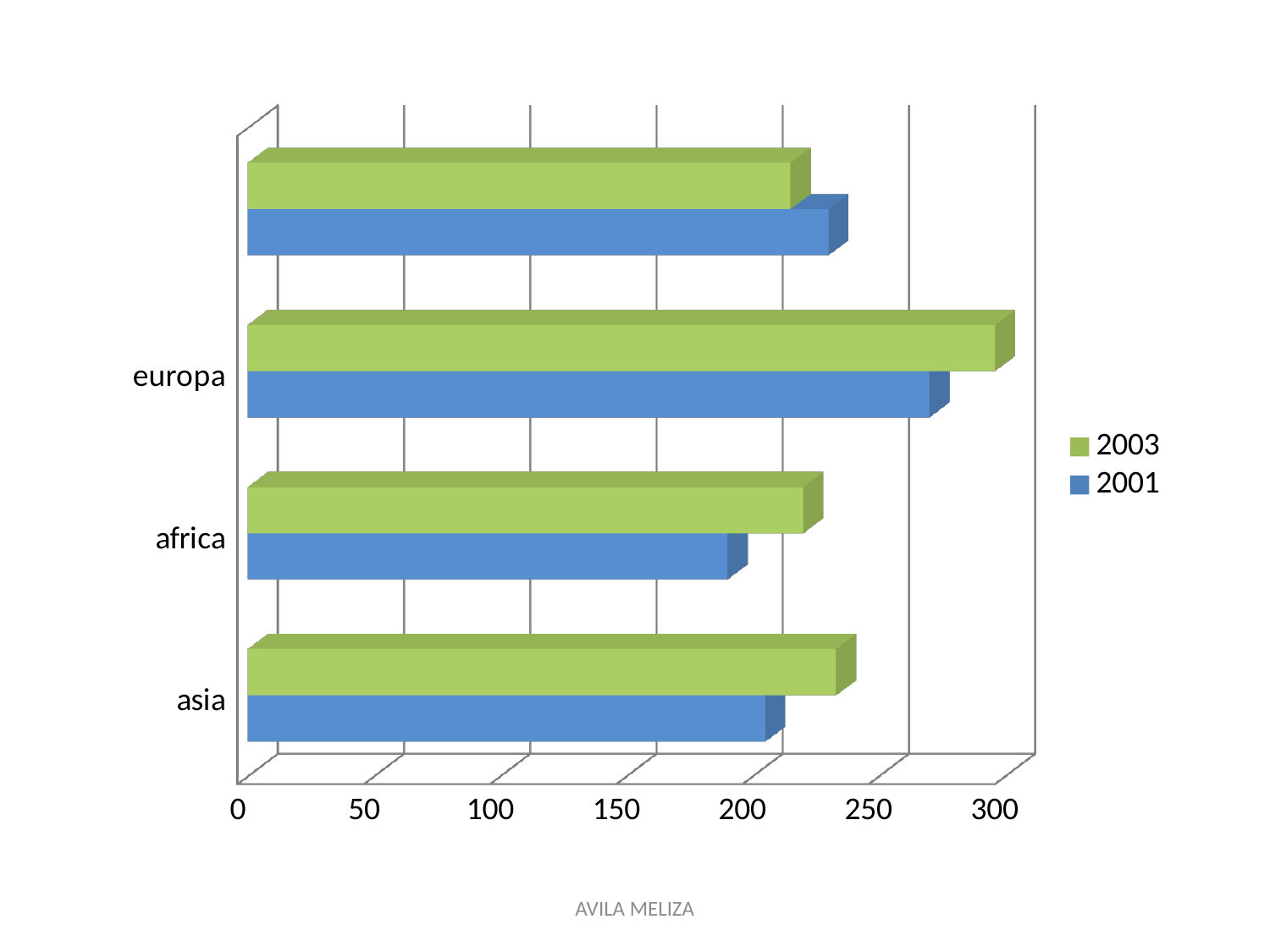
Which category has the highest value for 2001? europa For europa, which is larger, the 2003 value or the 2001 value? 2003 What kind of chart is shown on the slide? bar chart For africa, which is larger, the 2003 value or the 2001 value? 2003 Is the 2003 value for asia greater or less than 200? greater Which series is shown in blue? 2001 Is the 2001 value for europa greater or less than 250? greater How many series does the legend list? 2 Which series is shown in green? 2003 Is the 2001 value for africa greater or less than 250? less Which category has the highest value for 2003? europa